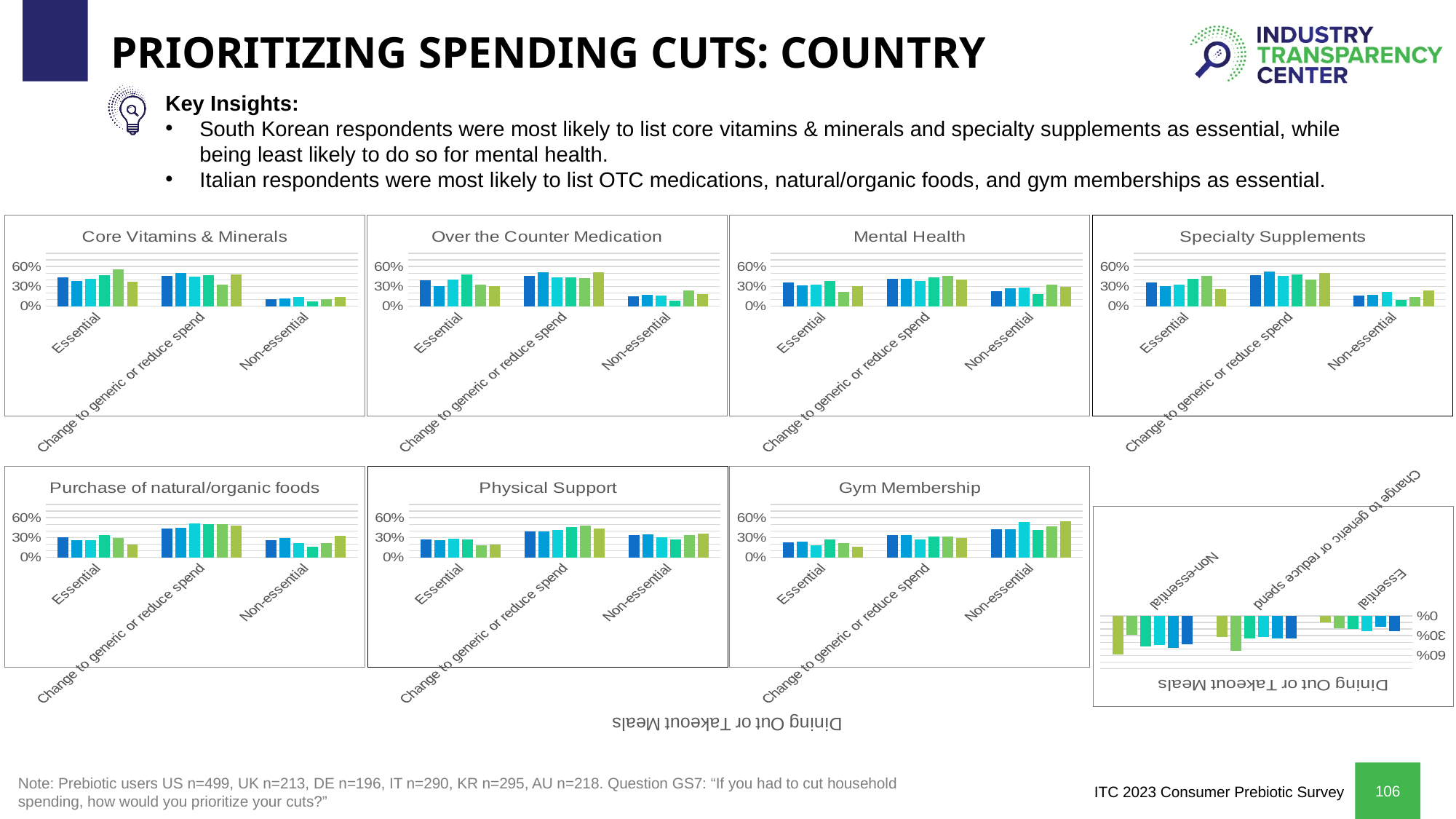
In the Mental Health chart, is the tallest bar for Essential greater or less than 60%? less How many charts are on the slide? 8 How many categories are shown on the x axis of the Mental Health chart? 3 In the Purchase of natural/organic foods chart, is the tallest bar for Change to generic or reduce spend greater or less than 30%? greater In the Core Vitamins & Minerals chart, which category has the lowest bars? Non-essential In the Gym Membership chart, is the tallest bar for Non-essential greater or less than 30%? greater What is the highest tick value shown on the y axis of the Physical Support chart? 60% In the Gym Membership chart, which category has the tallest bars, Essential or Non-essential? Non-essential In the Purchase of natural/organic foods chart, which category has the highest bars? Change to generic or reduce spend What kind of chart is the Core Vitamins & Minerals chart? bar chart What is the title of the rotated chart at the bottom right of the slide? Dining Out or Takeout Meals